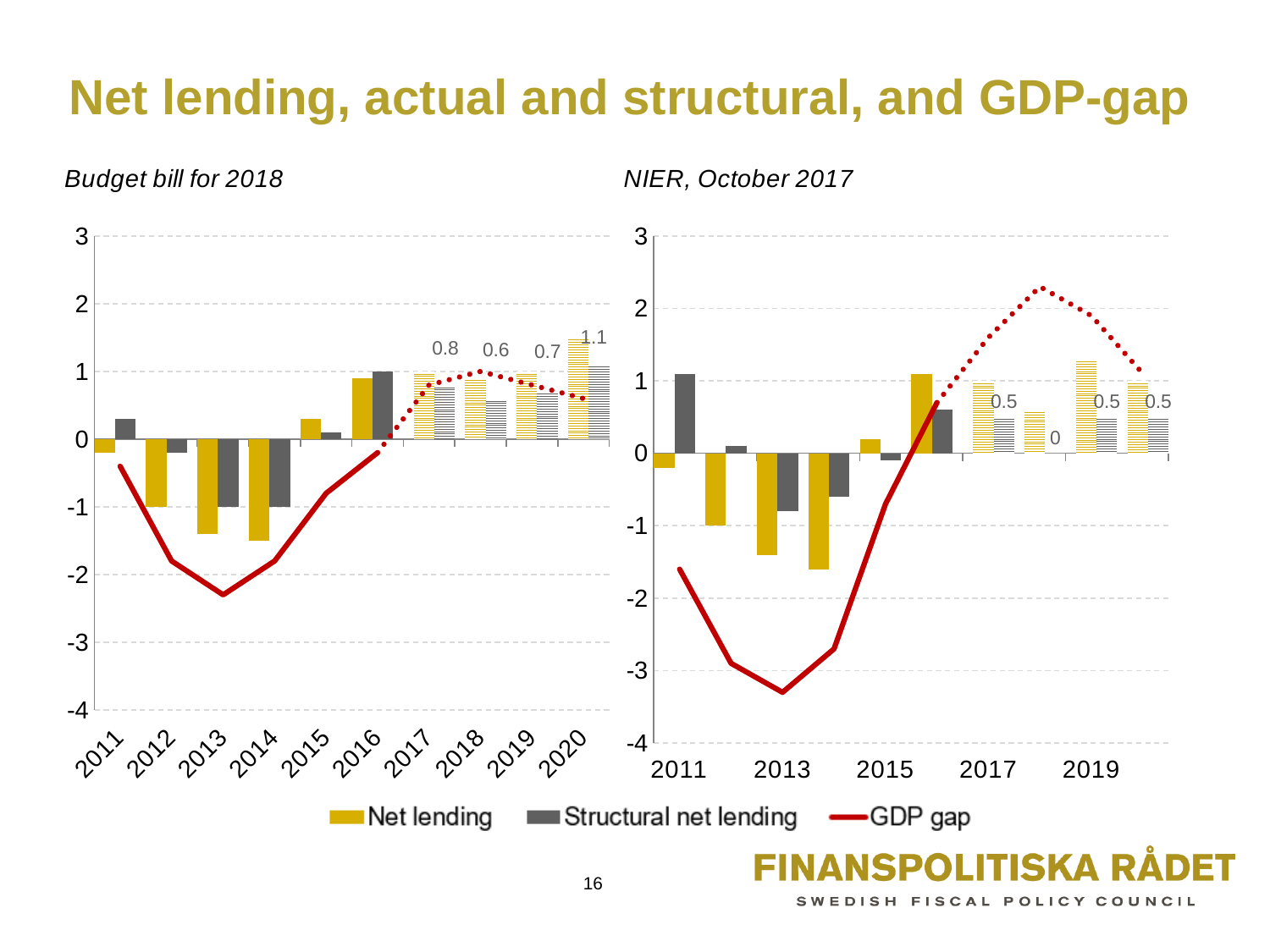
In the right chart (NIER, October 2017), is the GDP gap value for 2013 greater or less than -3? less In the right chart (NIER, October 2017), what data label is printed for 2018? 0 In the left chart (Budget bill for 2018), what data label is printed for 2020? 1.1 In the right chart (NIER, October 2017), does the GDP gap rise or fall from 2013 to 2018? rise In the right chart (NIER, October 2017), is the GDP gap value for 2018 greater or less than 2? greater In the left chart (Budget bill for 2018), which year has the highest printed data label? 2020 In the right chart (NIER, October 2017), in which year is the GDP gap at its lowest? 2013 In the left chart (Budget bill for 2018), is the GDP gap value for 2013 greater or less than -2? less In the left chart (Budget bill for 2018), what data label is printed for 2018? 0.6 How many series does the legend list? 3 In the left chart (Budget bill for 2018), in which year is the GDP gap at its lowest? 2013 In the right chart (NIER, October 2017), which is larger in 2011: Net lending or Structural net lending? Structural net lending